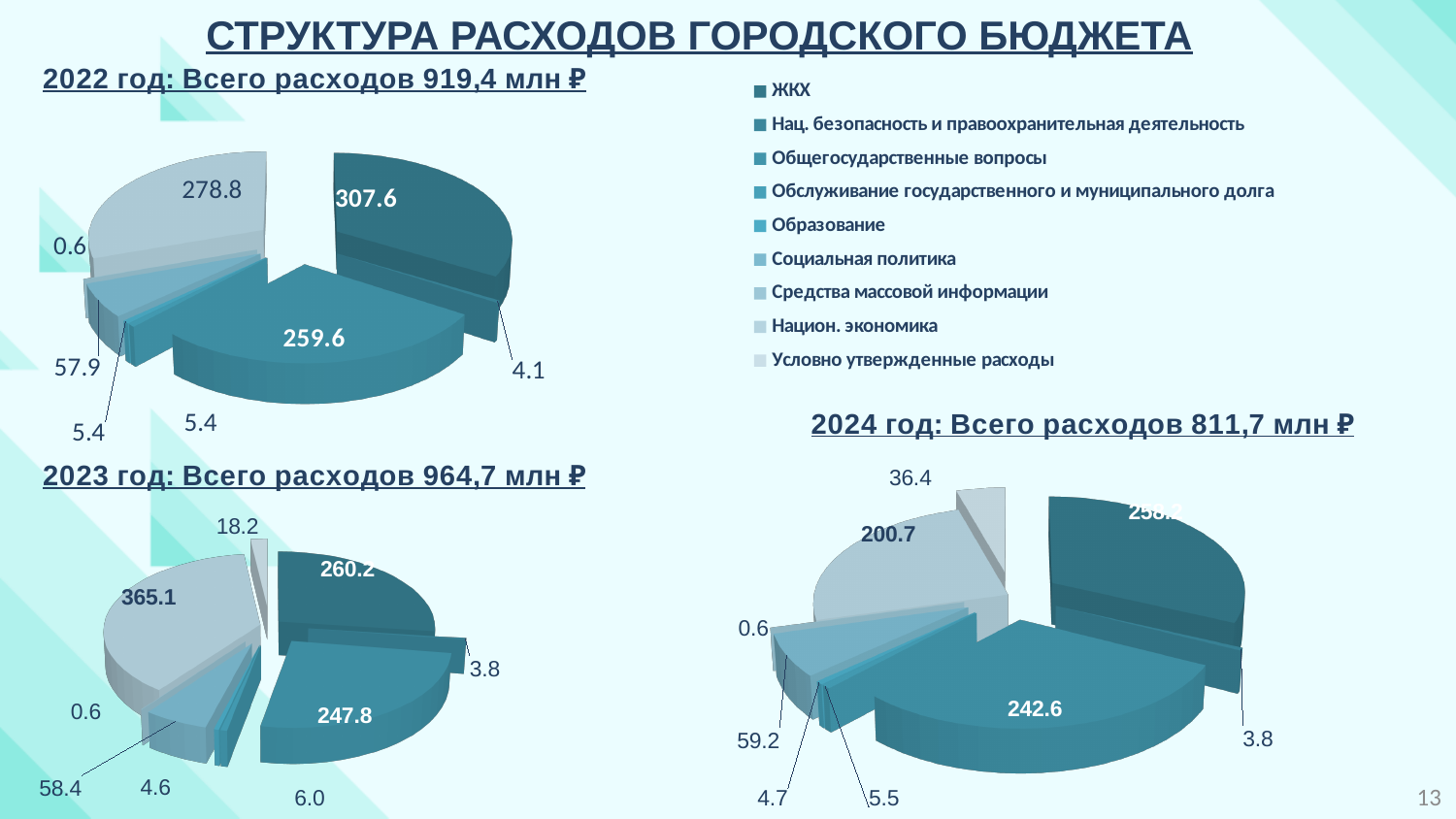
How many labelled slices does the 2023 chart have? 9 On the 2023 chart, what is the difference between the two largest slices, 365.1 and 260.2? 104.9 On the 2024 chart, which is larger: the slice labelled 242.6 or the slice labelled 200.7? 242.6 What is the total expenditure stated in the title of the 2023 chart? 964,7 млн ₽ On the 2024 chart, what is the smallest labelled slice value? 0.6 How many categories does the legend list? 9 On the 2024 chart, what is the largest labelled slice value? 258.2 What kind of charts are shown on the slide? Pie charts On the 2023 chart, what is the largest labelled slice value? 365.1 On the 2022 chart, what is the largest labelled slice value? 307.6 Which year's chart shows the highest total expenditure? 2023 What is the total expenditure stated in the title of the 2022 chart? 919,4 млн ₽